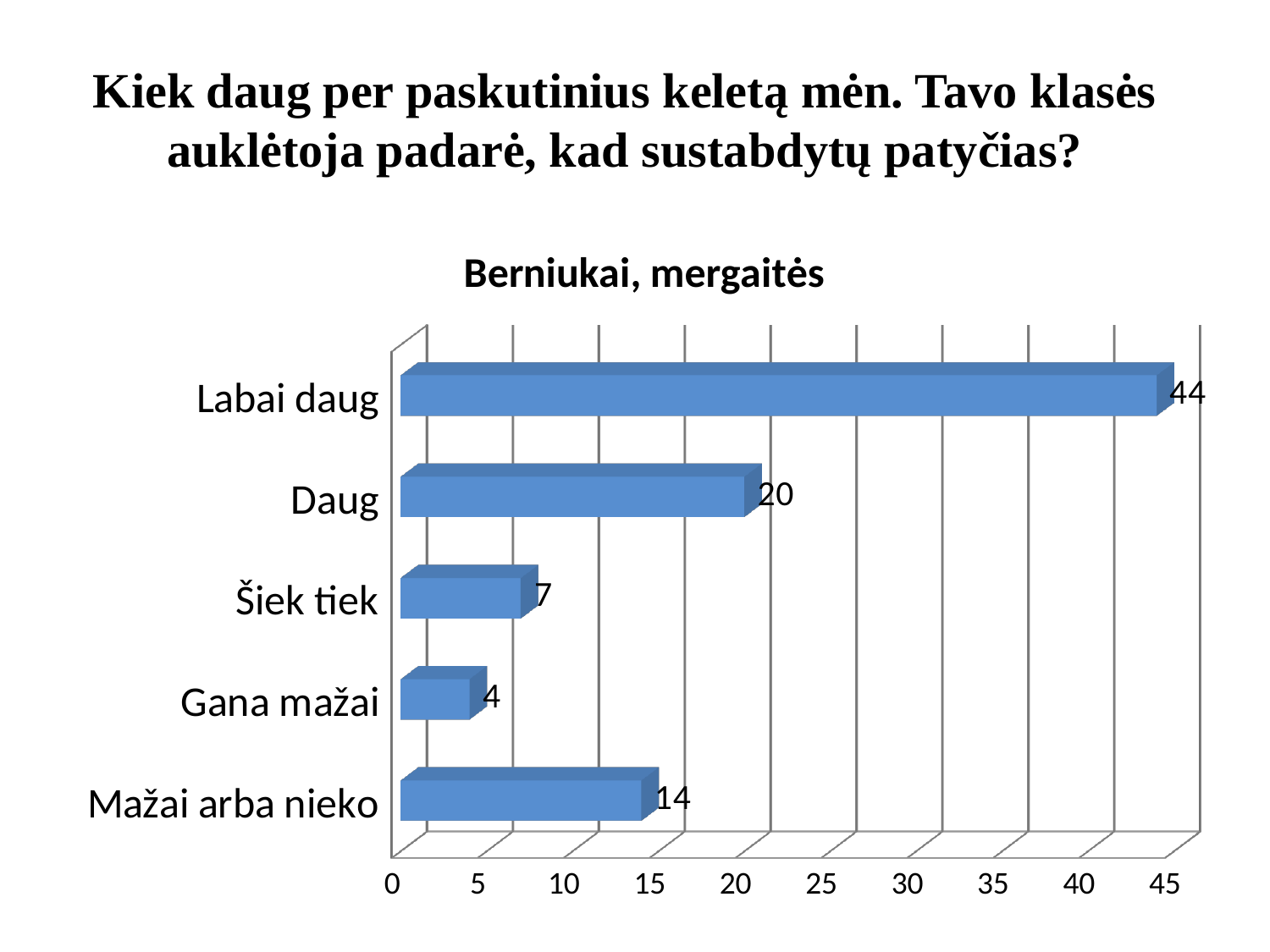
What kind of chart is shown on the slide? Bar chart What is the value for "Mažai arba nieko"? 14 What is the value for "Gana mažai"? 4 What is the value for "Labai daug"? 44 What is the difference between the values for "Labai daug" and "Daug"? 24 Which category has the highest value? Labai daug How many categories are shown in the chart? 5 What is the title of the chart? Berniukai, mergaitės Which category has the lowest value? Gana mažai Which is larger, the value for "Mažai arba nieko" or the value for "Šiek tiek"? Mažai arba nieko What is the value for "Šiek tiek"? 7 What is the value for "Daug"? 20